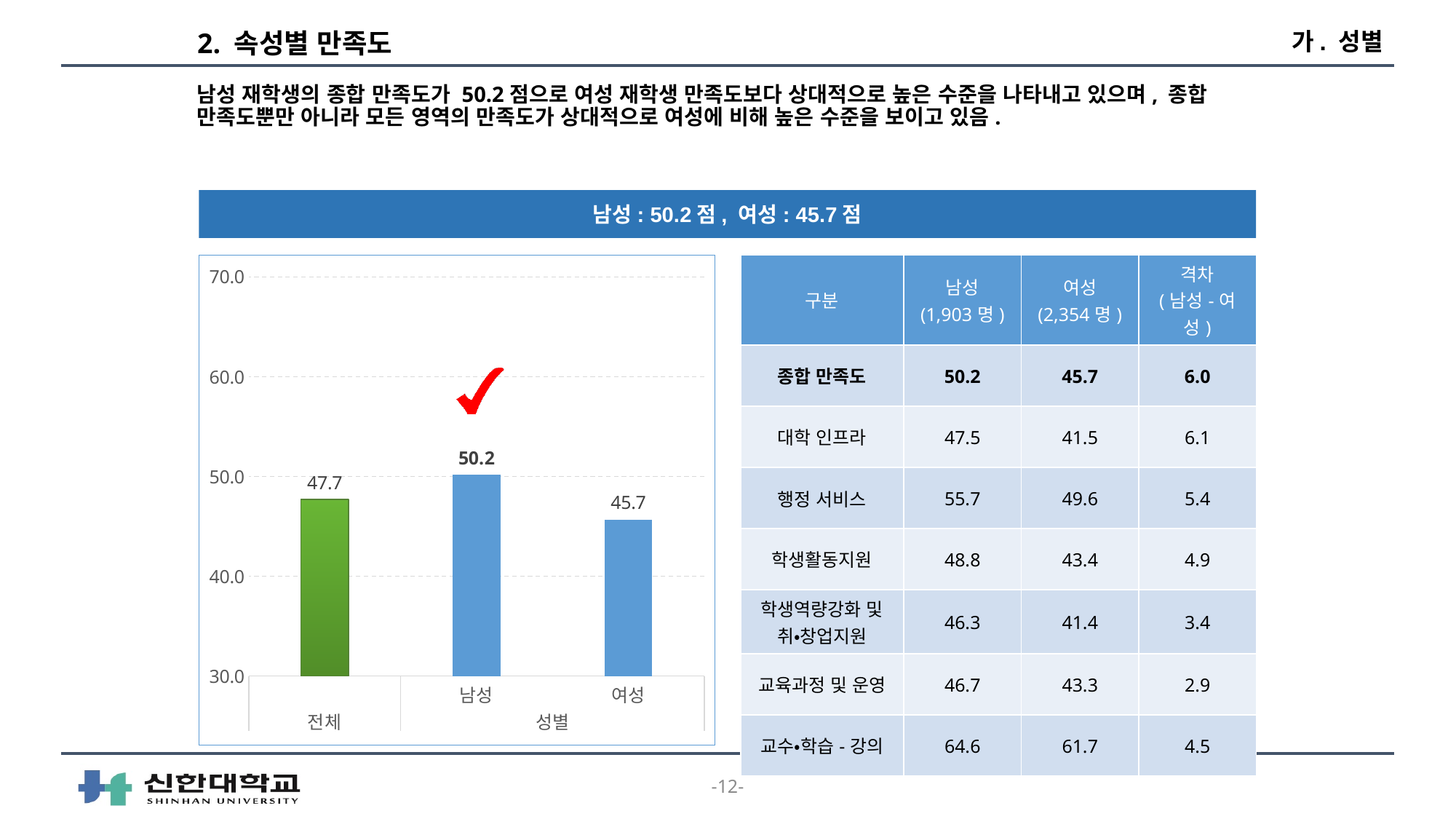
What is the difference between the 남성 and 전체 values in the chart? 2.5 Which category has the highest bar in the chart? 남성 What colour is the bar for 전체 in the chart? green What kind of chart is shown on the slide? bar chart Which category has the lowest bar in the chart? 여성 What is the value of the bar for 전체 in the chart? 47.7 Which is larger in the chart, the value for 전체 or the value for 여성? 전체 How many bars are plotted in the chart? 3 Is the value for 남성 greater or less than 50.0 on the chart's axis? greater What is the difference between the 남성 and 여성 values in the chart? 4.5 What is the value of the bar for 남성 in the chart? 50.2 What is the value of the bar for 여성 in the chart? 45.7